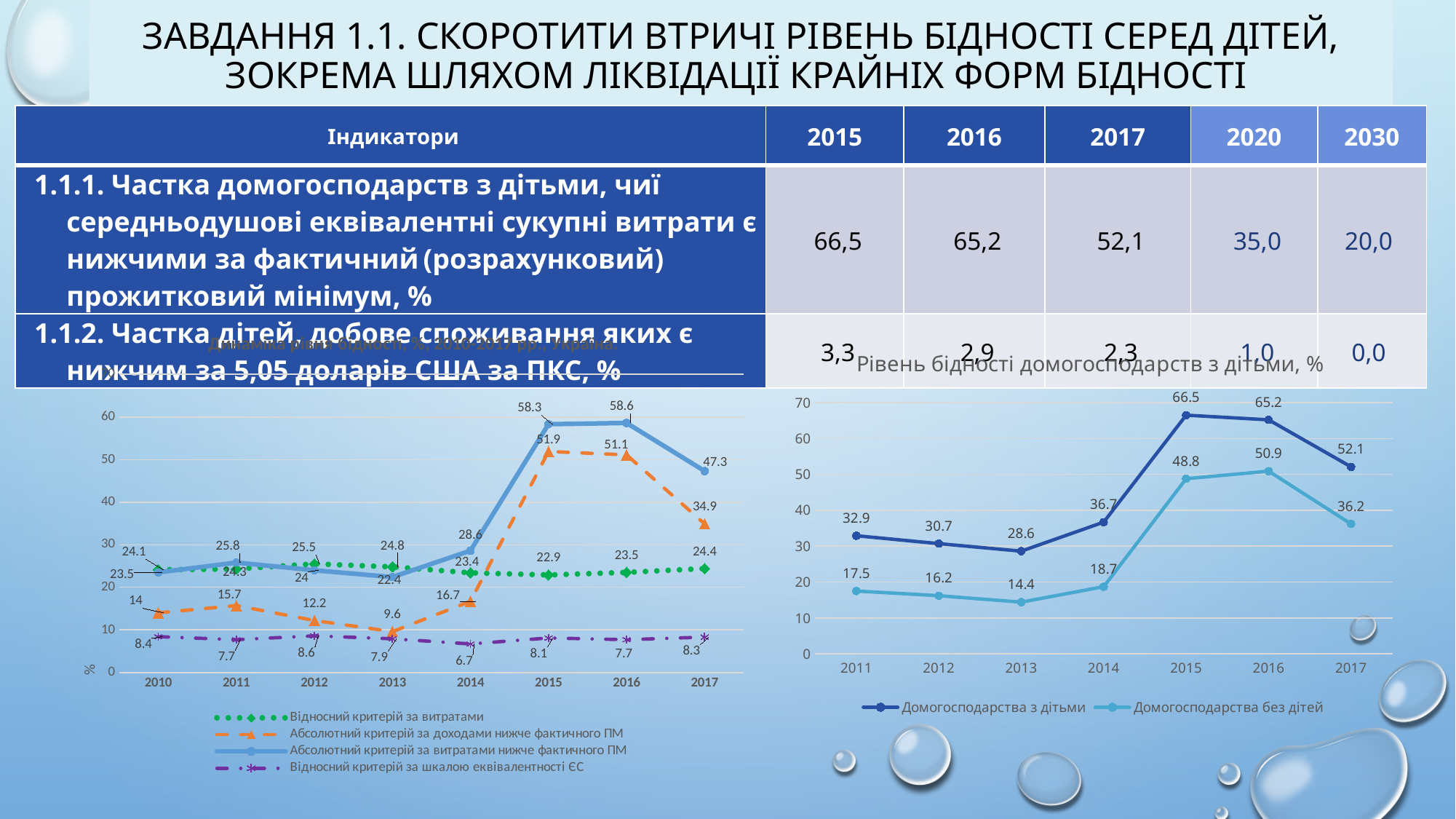
In the chart on the right, in which year is the value for households with children lowest? 2013 What kind of chart is the chart on the left? Line chart In the chart on the right, what is the value for households without children (Домогосподарства без дітей) in 2013? 14.4 In the chart on the left, what is the value of the series 'Абсолютний критерій за витратами нижче фактичного ПМ' in 2016? 58.6 In the chart on the right, what is the difference between households with children and households without children in 2017? 15.9 In the chart on the left, how many series does the legend list? 4 In the chart on the right, how many years are shown on the x axis? 7 In the chart on the left, which is larger in 2017: 'Абсолютний критерій за доходами нижче фактичного ПМ' or 'Відносний критерій за витратами'? Абсолютний критерій за доходами нижче фактичного ПМ In the chart on the right, what is the value for households with children (Домогосподарства з дітьми) in 2015? 66.5 In the chart on the right, how many series does the legend list? 2 In the chart on the left, what is the value of the series 'Відносний критерій за шкалою еквівалентності ЄС' in 2014? 6.7 In the chart on the right, in which year is the value for households without children highest? 2016